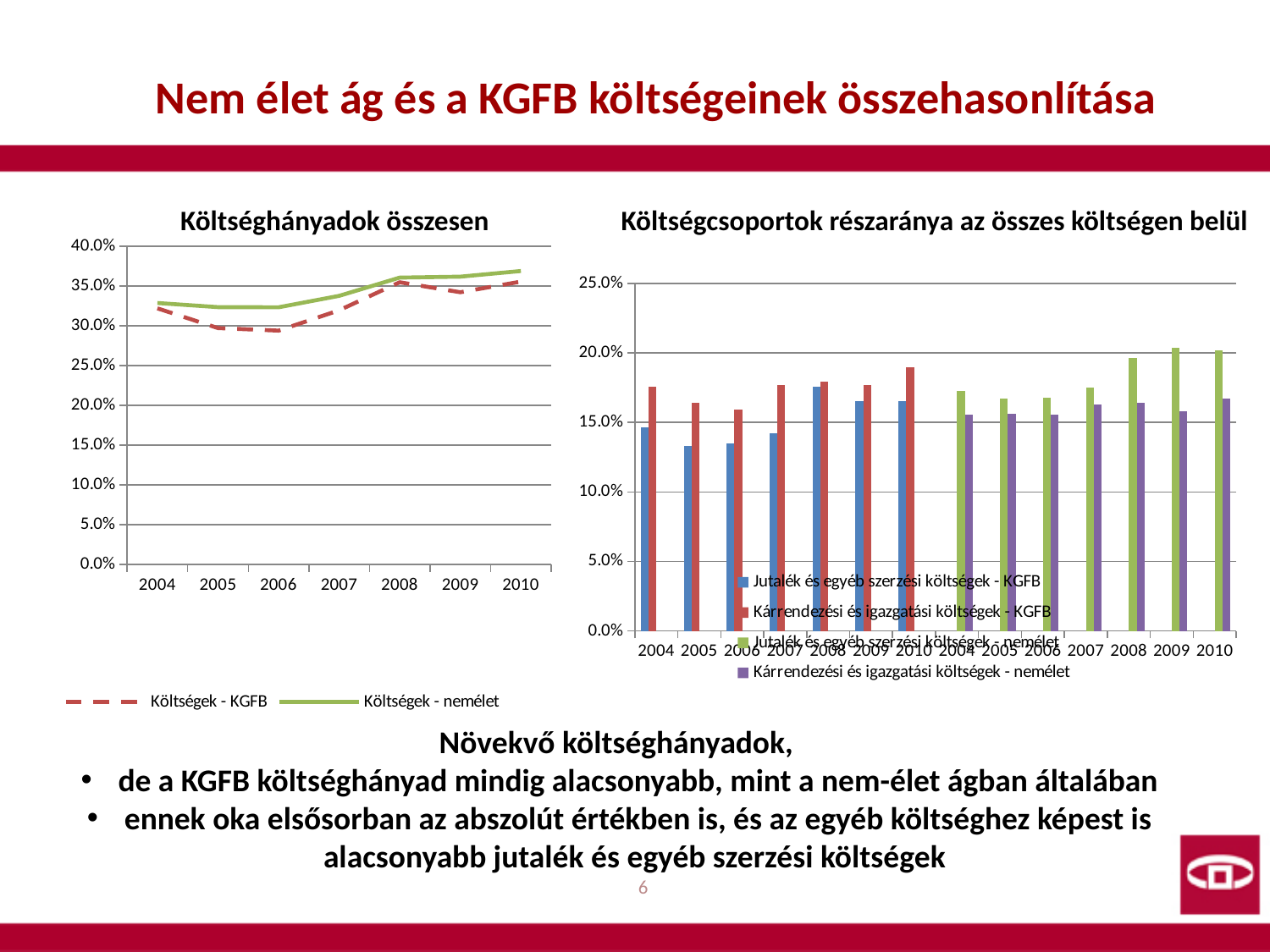
In the right chart "Költségcsoportok részaránya az összes költségen belül", is the value for Jutalék és egyéb szerzési költségek - nemélet in 2009 greater or less than 20.0%? greater In the left chart "Költséghányadok összesen", is the value for Költségek - nemélet in 2010 greater or less than 35.0%? greater In the left chart "Költséghányadok összesen", does the Költségek - nemélet series rise or fall overall from 2004 to 2010? rise In the left chart "Költséghányadok összesen", how many series does the legend list? 2 In the left chart "Költséghányadok összesen", how many years are shown on the x axis? 7 In the left chart "Költséghányadok összesen", which series has the higher value in 2006, Költségek - KGFB or Költségek - nemélet? Költségek - nemélet In the right chart "Költségcsoportok részaránya az összes költségen belül", which is larger in 2005, Jutalék és egyéb szerzési költségek - KGFB or Kárrendezési és igazgatási költségek - KGFB? Kárrendezési és igazgatási költségek - KGFB In the left chart "Költséghányadok összesen", is the value for Költségek - KGFB in 2006 greater or less than 30.0%? less What kind of chart is the left chart titled "Költséghányadok összesen"? line chart In the right chart "Költségcsoportok részaránya az összes költségen belül", how many series does the legend list? 4 What kind of chart is the right chart titled "Költségcsoportok részaránya az összes költségen belül"? bar chart